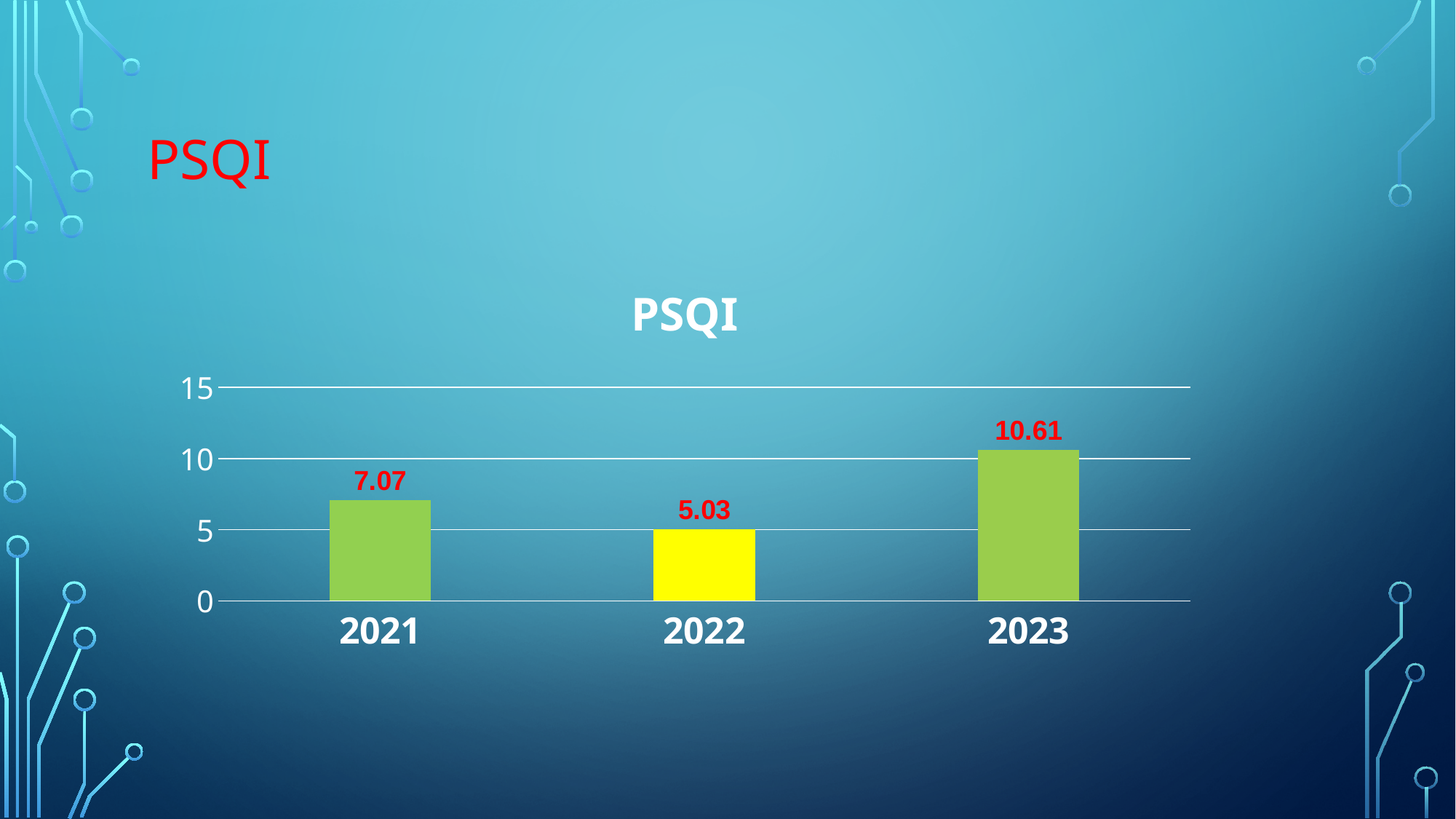
Is the PSQI value for 2023 greater or less than 10? greater What is the difference between the PSQI values for 2021 and 2022? 2.04 What is the PSQI value for 2023? 10.61 What kind of chart is shown on the slide? bar chart What is the PSQI value for 2022? 5.03 What is the difference between the PSQI values for 2023 and 2021? 3.54 How many years are shown on the chart? 3 Which is larger, the PSQI value for 2021 or for 2022? 2021 What is the PSQI value for 2021? 7.07 Which year has the highest PSQI value? 2023 Which year has the lowest PSQI value? 2022 What is the title of the chart? PSQI